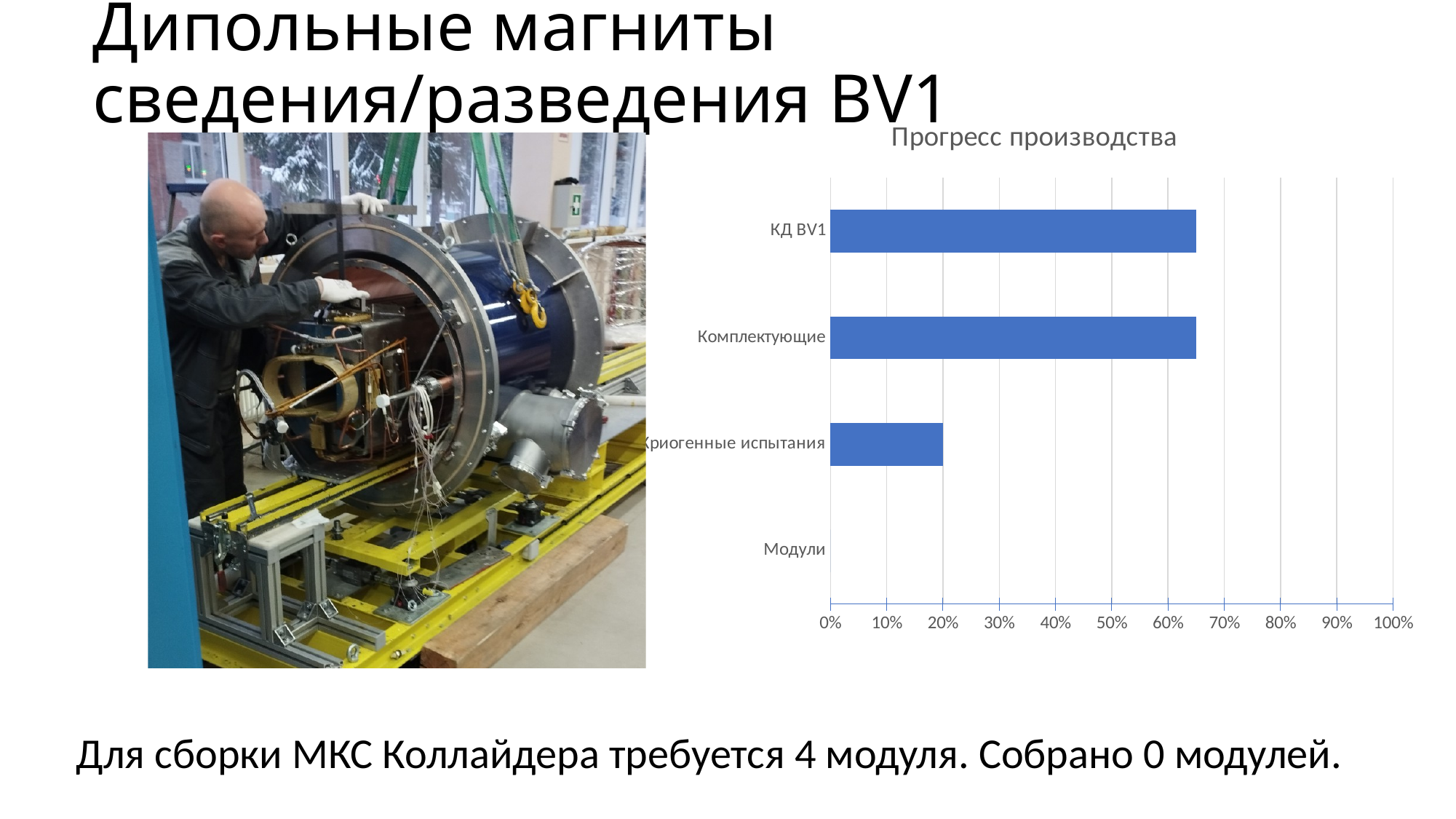
Which is larger, the value for Комплектующие or the value for Криогенные испытания? Комплектующие How many categories are shown in the chart? 4 Is the value for Криогенные испытания greater or less than 50%? less Is the value for КД BV1 greater or less than 60%? greater What kind of chart is shown on the slide? bar chart What is the highest value shown on the horizontal axis of the chart? 100% What is the title of the chart? Прогресс производства Which category has the lowest value in the chart? Модули Is the value for Комплектующие greater or less than 70%? less Which is larger, the value for КД BV1 or the value for Модули? КД BV1 What is the value for Криогенные испытания? 20%